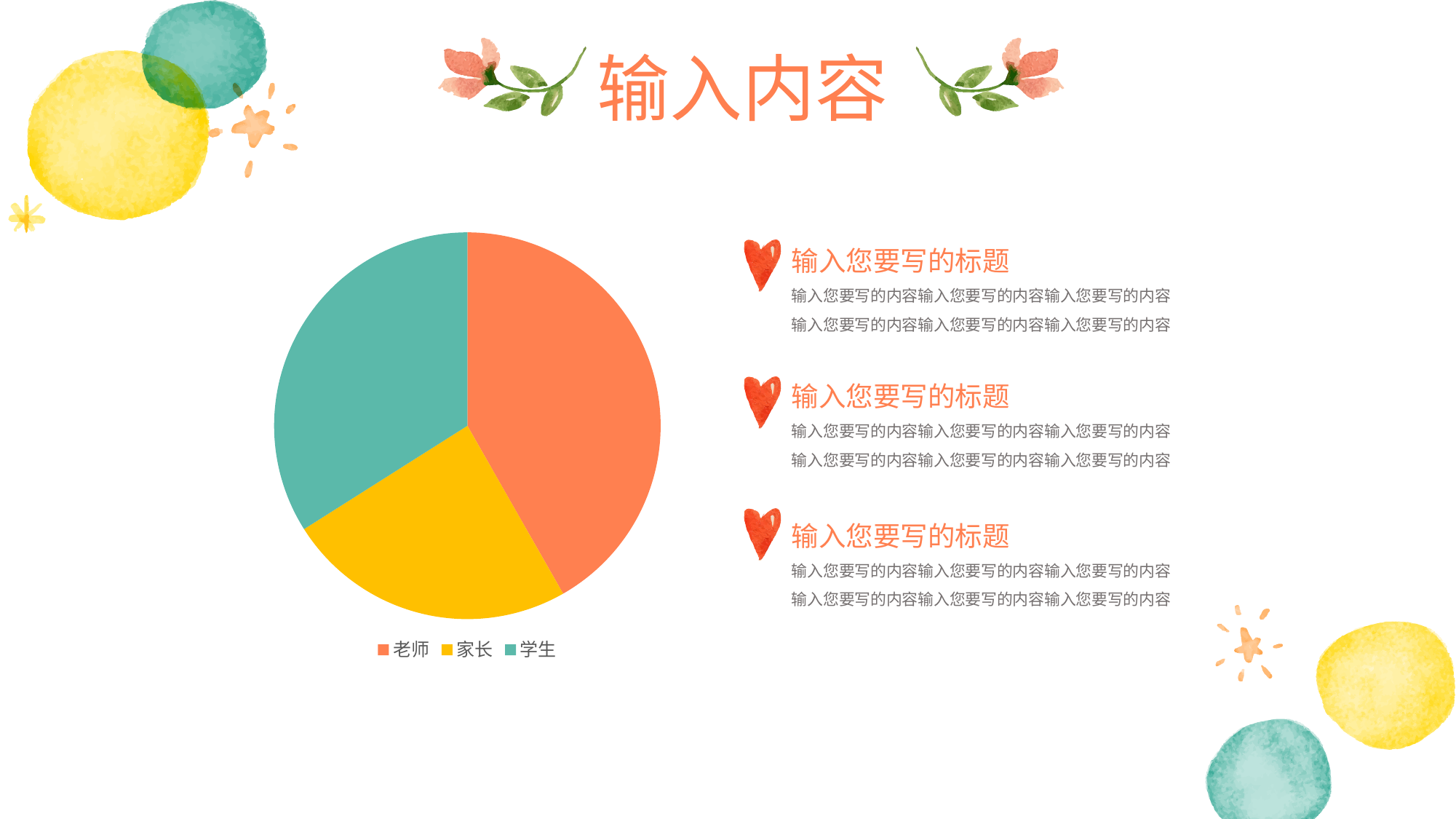
What colour is the 学生 slice in the pie chart? teal What kind of chart is shown on the slide? pie chart How many entries does the legend of the pie chart list? 3 Which category has the largest slice in the pie chart? 老师 How many slices does the pie chart have? 3 Which category has the smallest slice in the pie chart? 家长 Which slice is larger in the pie chart, 老师 or 家长? 老师 What are the three legend entries of the pie chart, in order? 老师, 家长, 学生 Which slice is larger in the pie chart, 学生 or 家长? 学生